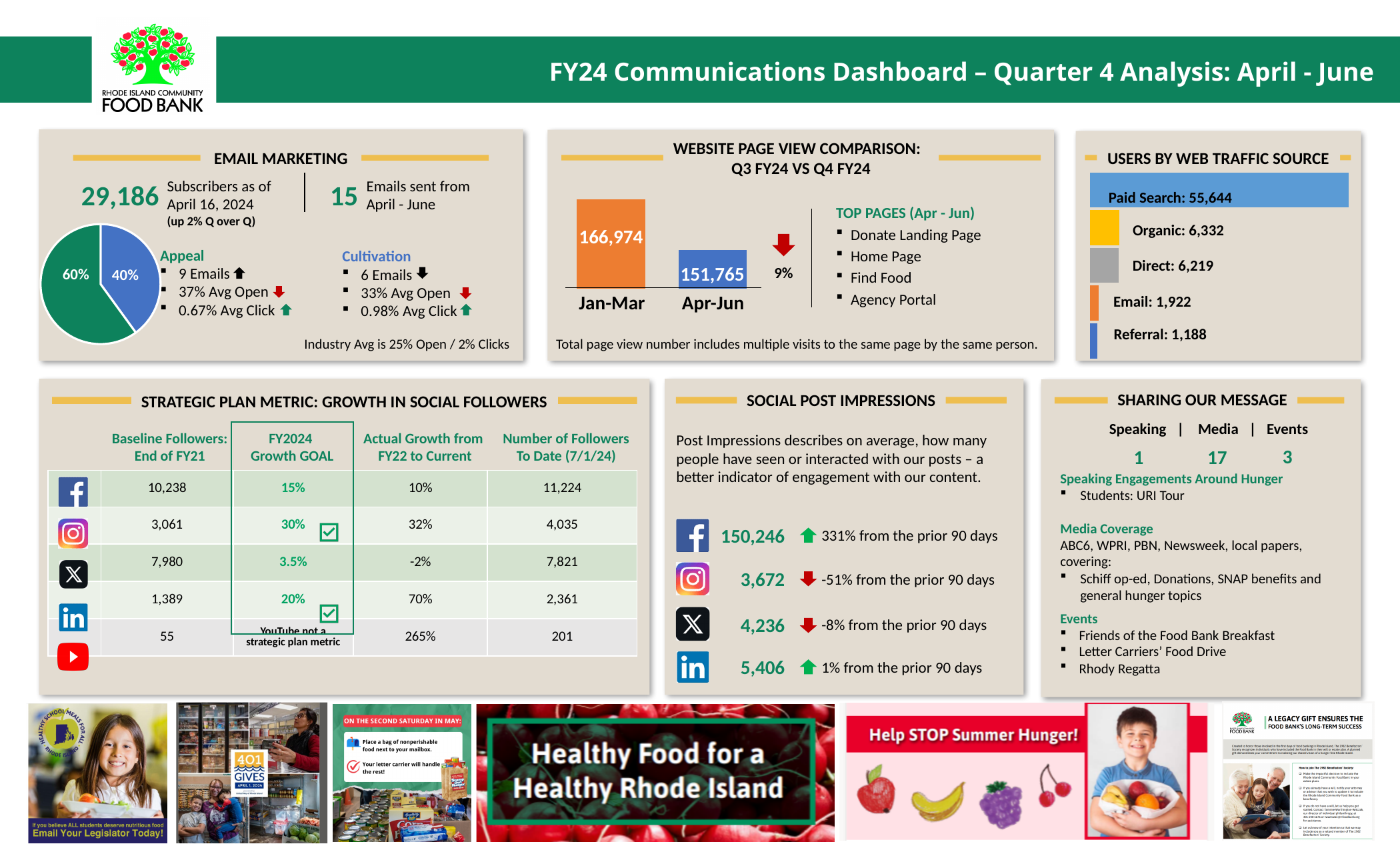
In the Website Page View Comparison chart, do page views rise or fall from Jan-Mar to Apr-Jun? fall In the Users by Web Traffic Source chart, what is the value for Paid Search? 55,644 What kind of chart is the Website Page View Comparison chart? bar chart How many traffic sources are shown in the Users by Web Traffic Source chart? 5 In the Website Page View Comparison chart, what is the value for Apr-Jun? 151,765 In the Website Page View Comparison chart, what is the value for Jan-Mar? 166,974 In the Users by Web Traffic Source chart, which source has the highest number of users? Paid Search In the Email Marketing pie chart, what share does the larger (green) slice represent? 60% In the Website Page View Comparison chart, which period has the higher page views, Jan-Mar or Apr-Jun? Jan-Mar In the Users by Web Traffic Source chart, what is the difference between Organic and Direct users? 113 In the Users by Web Traffic Source chart, which source has the lowest number of users? Referral In the Website Page View Comparison chart, what is the difference in page views between Jan-Mar and Apr-Jun? 15,209